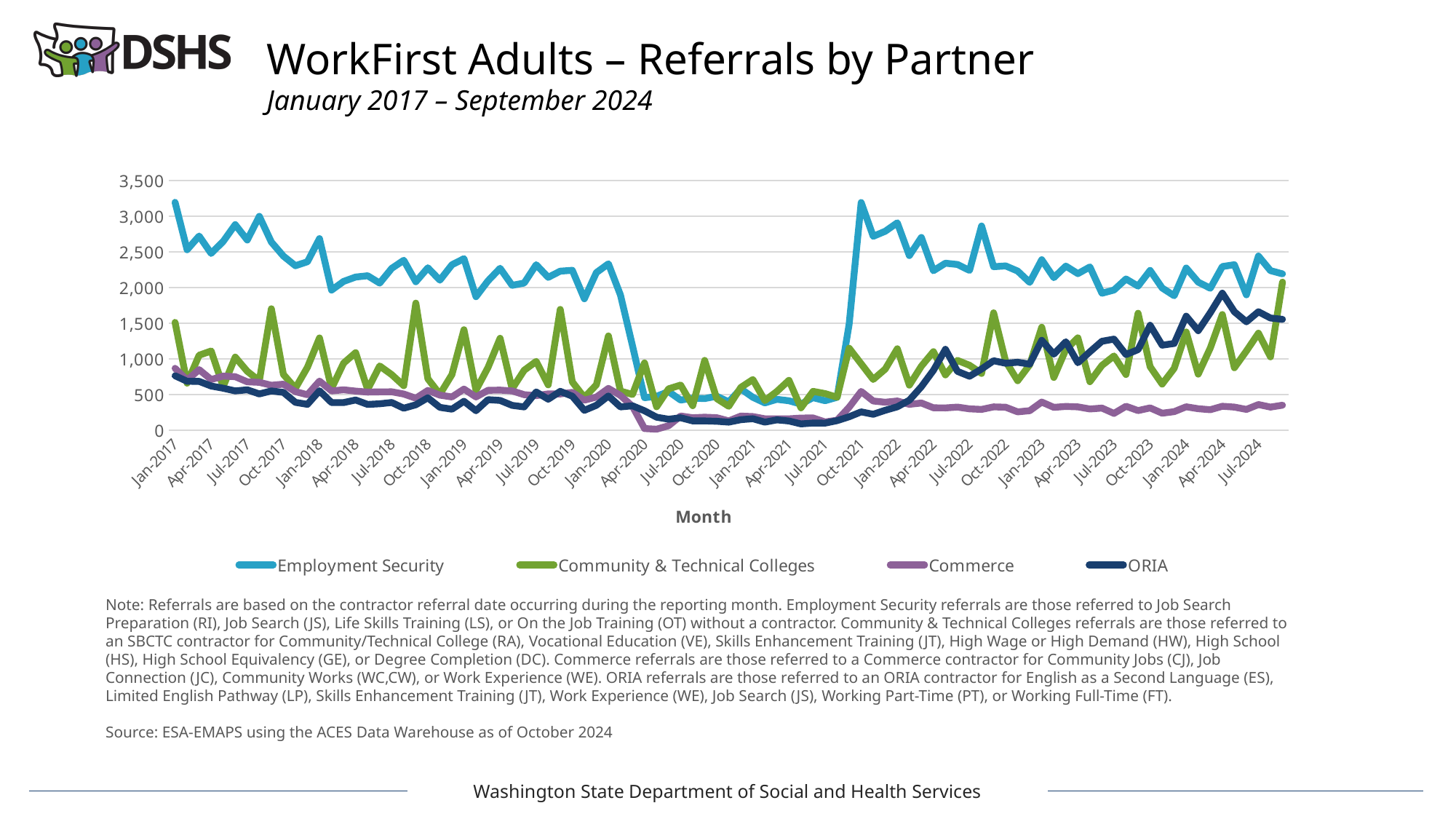
Is the value for Employment Security in Jan-2017 greater or less than 3,000? greater Is the value for Employment Security in Jul-2020 greater or less than 1,000? less Which series is highest in Jan-2017? Employment Security How many series does the legend list? 4 What is the title of the chart's x axis? Month What is the title of the chart? WorkFirst Adults – Referrals by Partner In Jul-2024, which is larger: ORIA or Commerce? ORIA Which series is lowest in Jul-2024? Commerce Is the value for ORIA in Apr-2024 greater or less than 1,500? greater What kind of chart is shown on the slide? Line chart Does the ORIA line generally rise or fall from Jan-2022 to Jul-2024? Rise